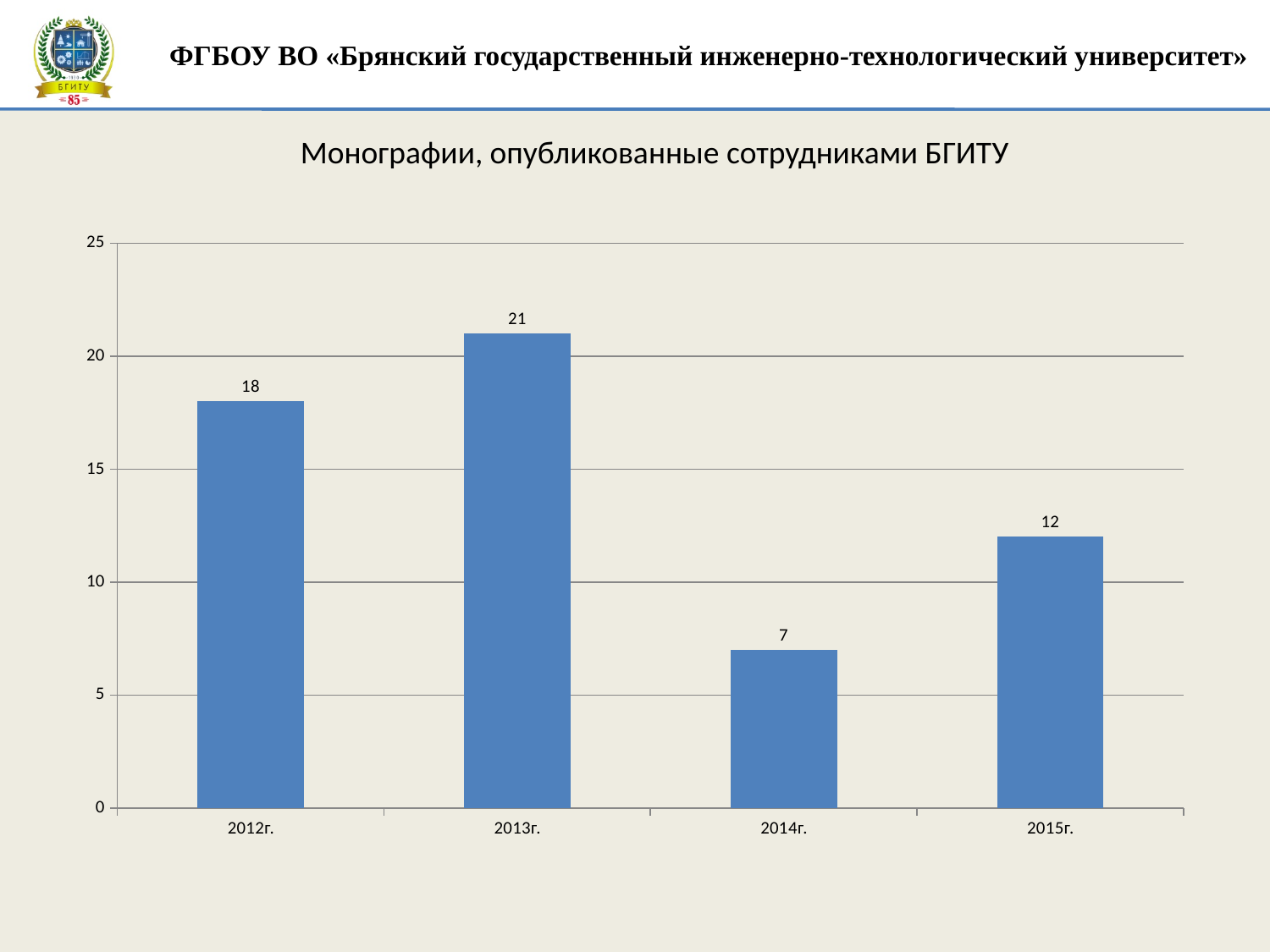
What is the value for 2012г.? 18 Which is larger, the value for 2012г. or the value for 2015г.? 2012г. What kind of chart is shown on the slide? bar chart Which year has the highest value? 2013г. What is the value for 2015г.? 12 Which year has the lowest value? 2014г. How many years are shown on the x axis? 4 What is the value for 2014г.? 7 What is the value for 2013г.? 21 What is the difference between the values for 2013г. and 2014г.? 14 Is the value for 2014г. greater or less than 10? less What is the title of the chart? Монографии, опубликованные сотрудниками БГИТУ